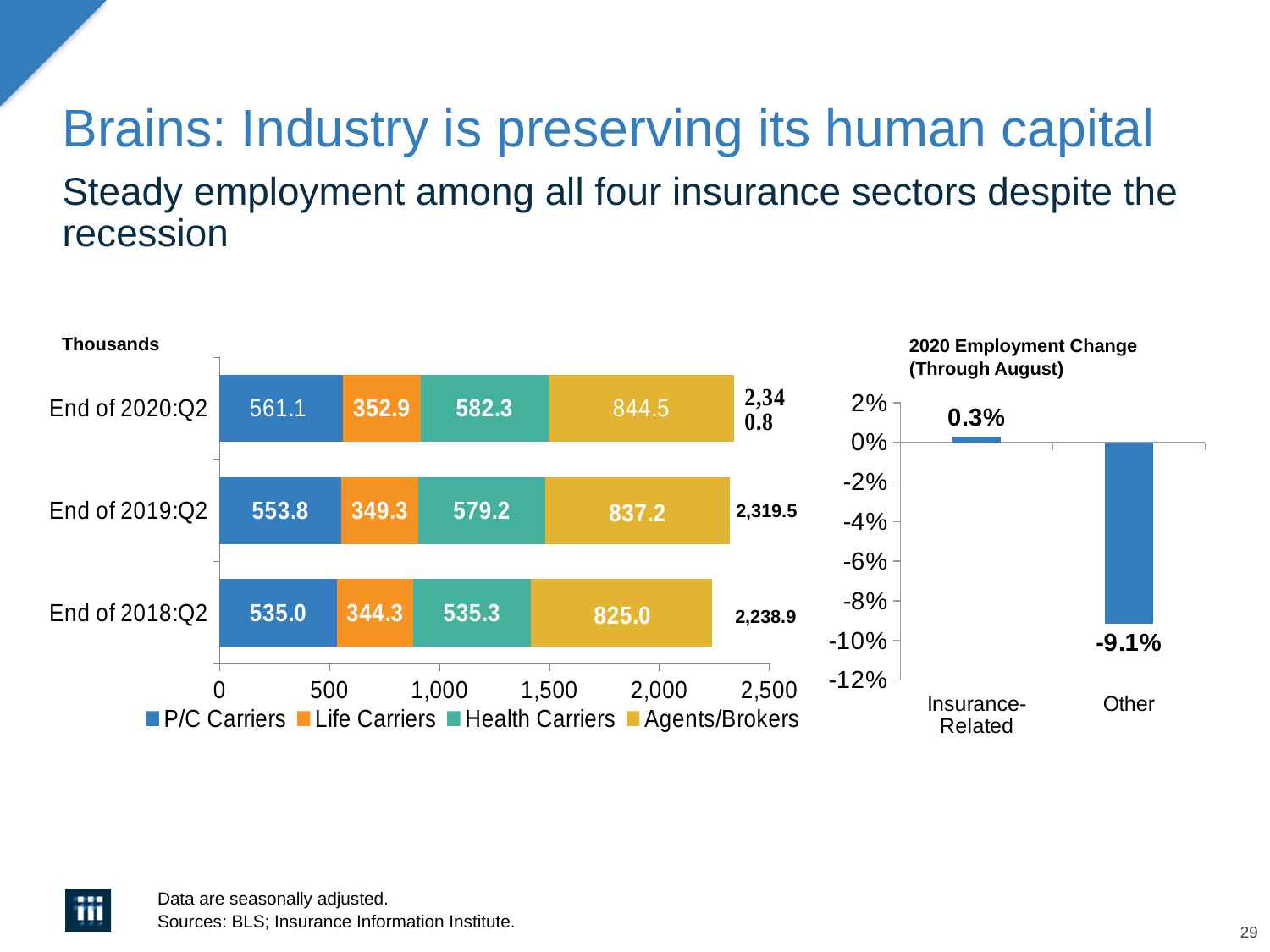
In the left stacked bar chart (Thousands), what is the total for the End of 2019:Q2 bar? 2,319.5 In the left stacked bar chart (Thousands), what is the value for Agents/Brokers at End of 2018:Q2? 825.0 What kind of chart is the chart titled '2020 Employment Change (Through August)'? Bar chart In the chart titled '2020 Employment Change (Through August)', what is the value for Insurance-Related? 0.3% In the left stacked bar chart (Thousands), how many time periods (bars) are shown? 3 In the left stacked bar chart (Thousands), how many series does the legend list? 4 In the left stacked bar chart (Thousands), what is the difference between the Life Carriers values at End of 2020:Q2 and End of 2018:Q2? 8.6 In the chart titled '2020 Employment Change (Through August)', what is the value for Other? -9.1% In the left stacked bar chart (Thousands), what is the value for Health Carriers at End of 2019:Q2? 579.2 In the left stacked bar chart (Thousands), which series has the largest value at End of 2020:Q2? Agents/Brokers In the left stacked bar chart (Thousands), which series has the smallest value at End of 2018:Q2? Life Carriers In the left stacked bar chart (Thousands), what is the value for P/C Carriers at End of 2020:Q2? 561.1